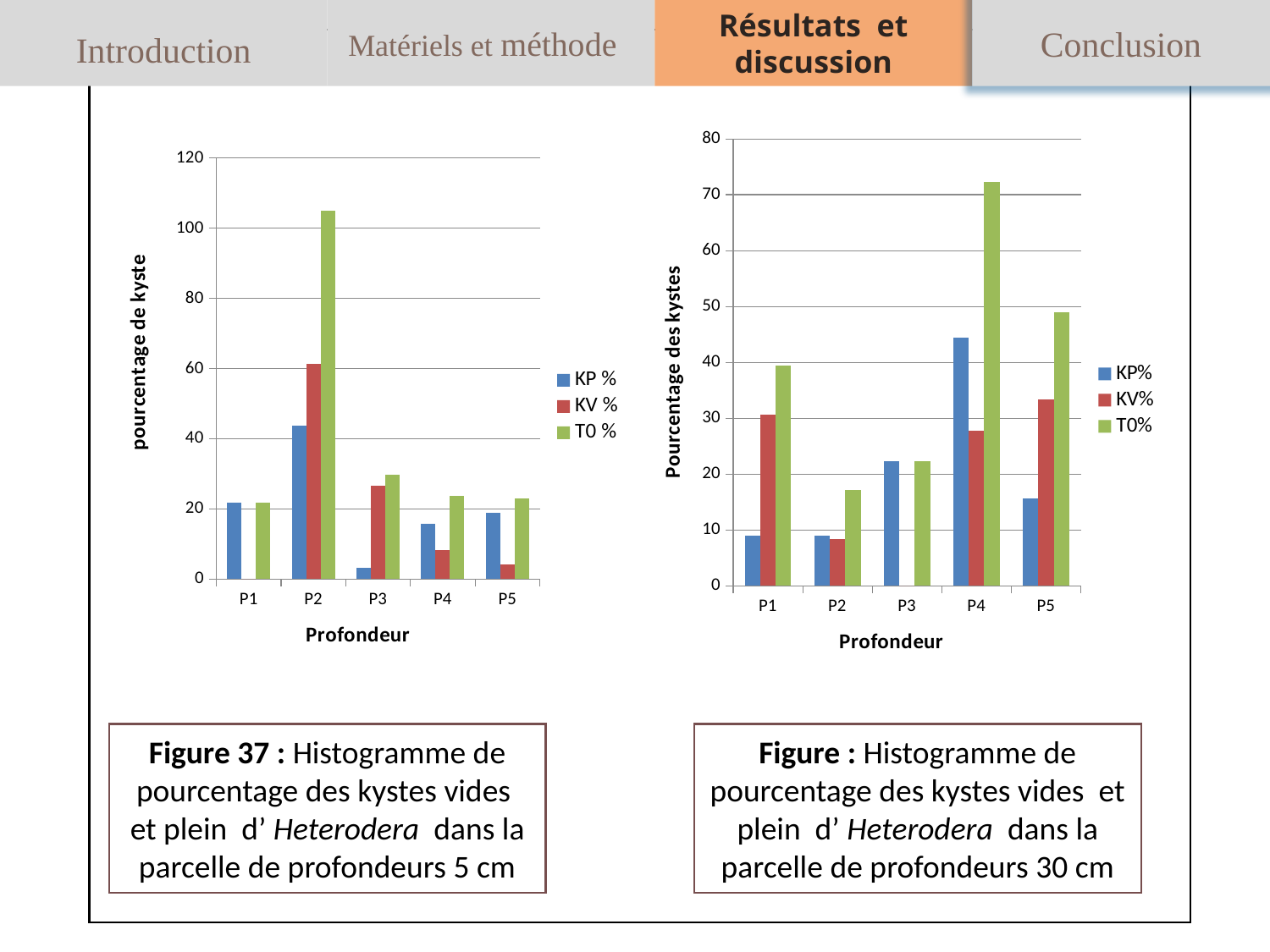
In the left chart (profondeurs 5 cm), at which profondeur is the KP % value lowest? P3 What is the x-axis title of the right chart (profondeurs 30 cm)? Profondeur In the right chart (profondeurs 30 cm), is the T0% value for P4 greater or less than 70? greater In the left chart (profondeurs 5 cm), is the T0 % value for P2 greater or less than 100? greater In the left chart (profondeurs 5 cm), which is larger at P2: KP % or KV %? KV % In the left chart (profondeurs 5 cm), at which profondeur is the T0 % value highest? P2 In the right chart (profondeurs 30 cm), at which profondeur is the T0% value highest? P4 How many series does the legend of the left chart (profondeurs 5 cm) list? 3 In the right chart (profondeurs 30 cm), is the KP% value for P1 greater or less than 10? less What kind of chart is the left chart (Figure 37, profondeurs 5 cm)? bar chart In the right chart (profondeurs 30 cm), which is larger at P4: KP% or KV%? KP% How many categories are shown on the x axis of the right chart (profondeurs 30 cm)? 5